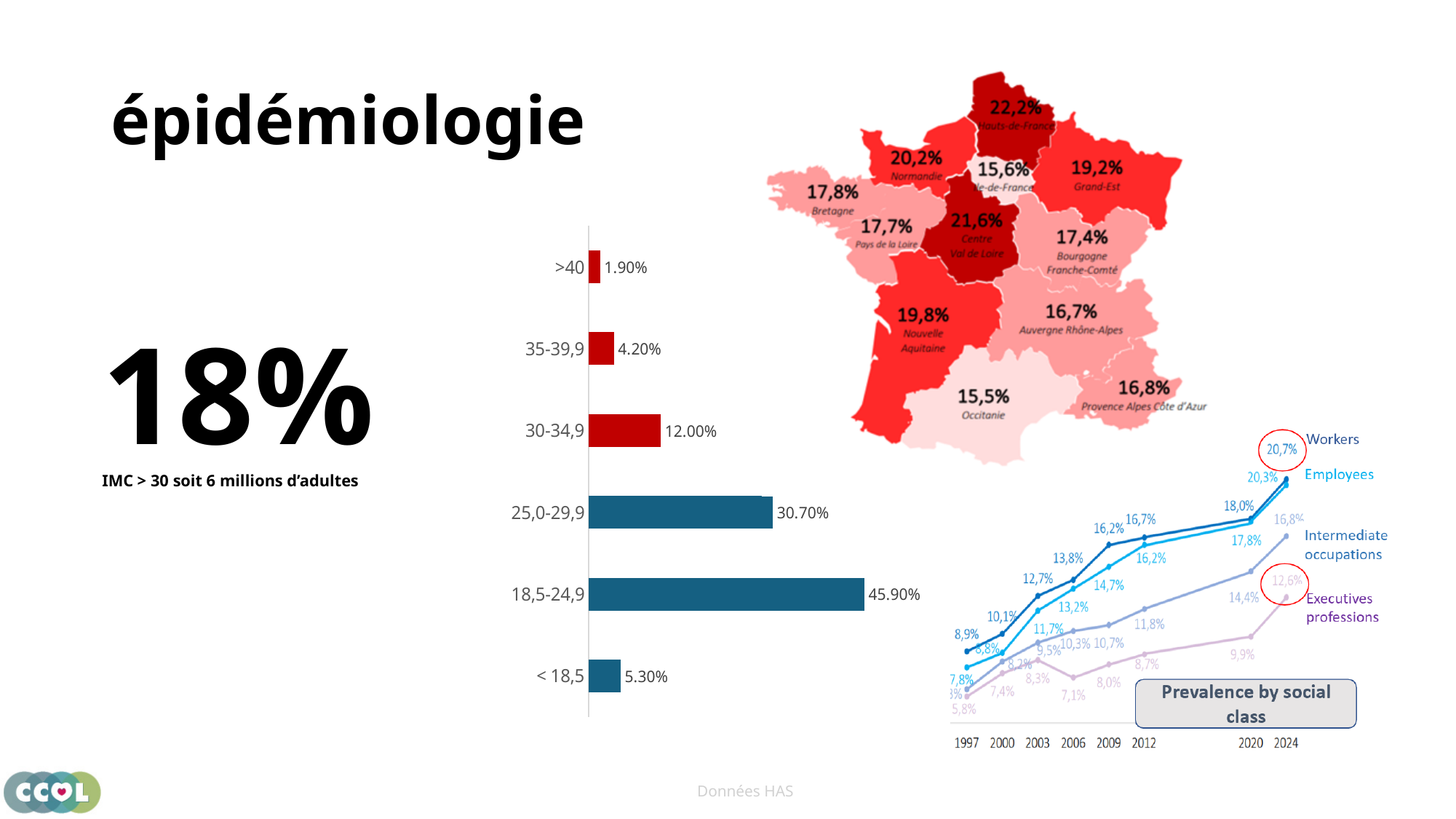
What kind of chart is the chart of BMI categories on the left-centre of the slide? bar chart In the bar chart of BMI categories, what is the difference between the values for 25,0-29,9 and 30-34,9? 18.70% How many categories does the bar chart of BMI categories show? 6 In the bar chart of BMI categories, which is larger: the value for < 18,5 or the value for 35-39,9? < 18,5 In the bar chart of BMI categories, what is the value for the 30-34,9 category? 12.00% In the bar chart of BMI categories, what is the value for the 18,5-24,9 category? 45.90% How many social classes (series) does the 'Prevalence by social class' line chart show? 4 In the 'Prevalence by social class' line chart, does the Workers series rise or fall from 1997 to 2024? rise In the 'Prevalence by social class' line chart, what is the value for Executives professions in 2024? 12,6% In the 'Prevalence by social class' line chart, what is the value for Workers in 2024? 20,7% In the bar chart of BMI categories, which category has the highest value? 18,5-24,9 In the bar chart of BMI categories, which category has the lowest value? >40